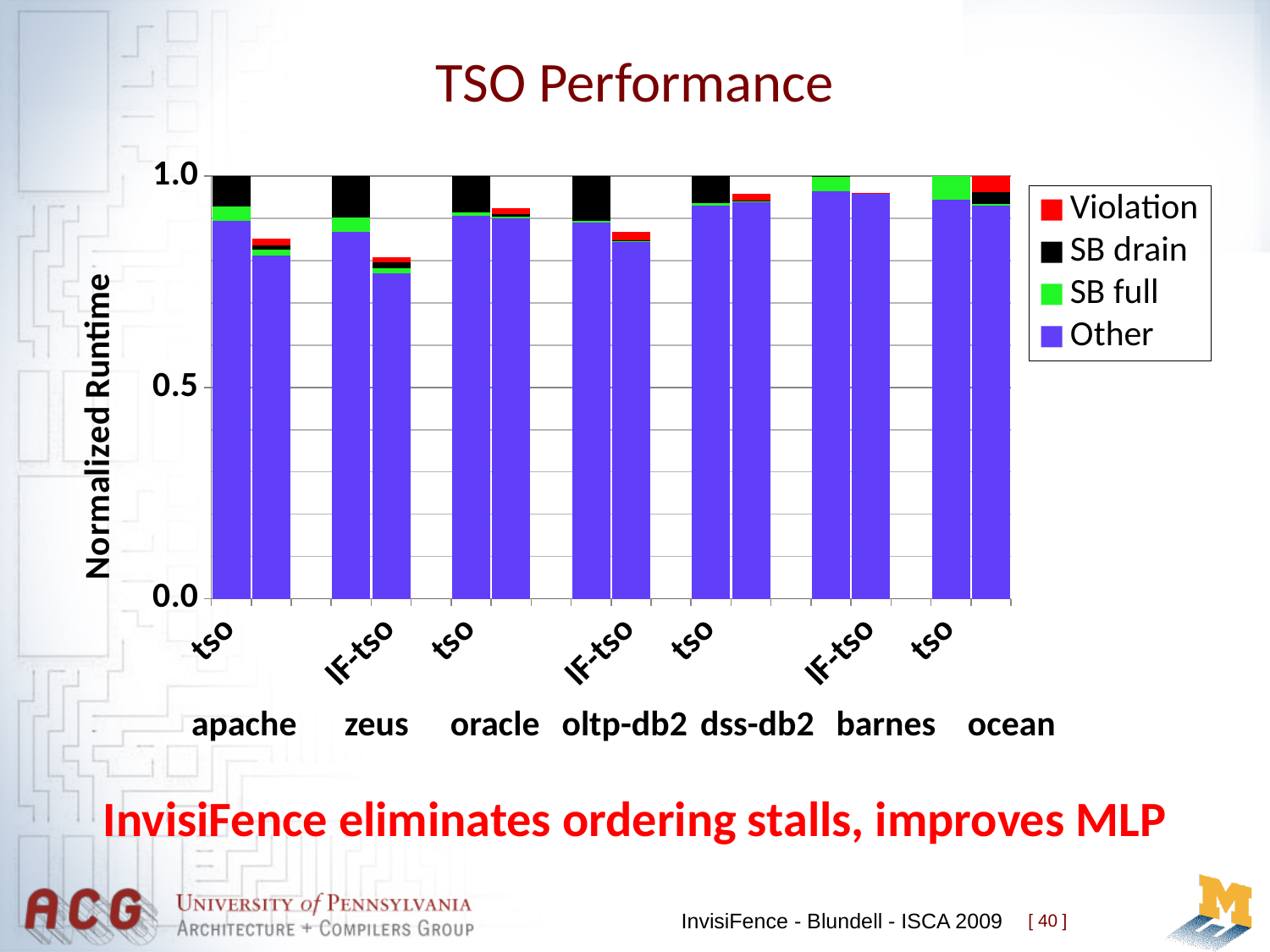
What kind of chart is shown on the slide? stacked bar chart What is the label of the y axis? Normalized Runtime Which benchmark has the lowest IF-tso bar? zeus Is the total height of the IF-tso bar for apache greater or less than 0.5? greater Is the total height of the IF-tso bar for zeus greater or less than 1.0? less For zeus, which bar is shorter, tso or IF-tso? IF-tso How many benchmarks are shown along the x axis? 7 For apache, which bar is taller, tso or IF-tso? tso Which benchmark's tso bar has the largest SB drain (black) segment? oltp-db2 Is the total height of the IF-tso bar for oltp-db2 greater or less than 1.0? less How many series does the legend list? 4 What is the title of the chart? TSO Performance